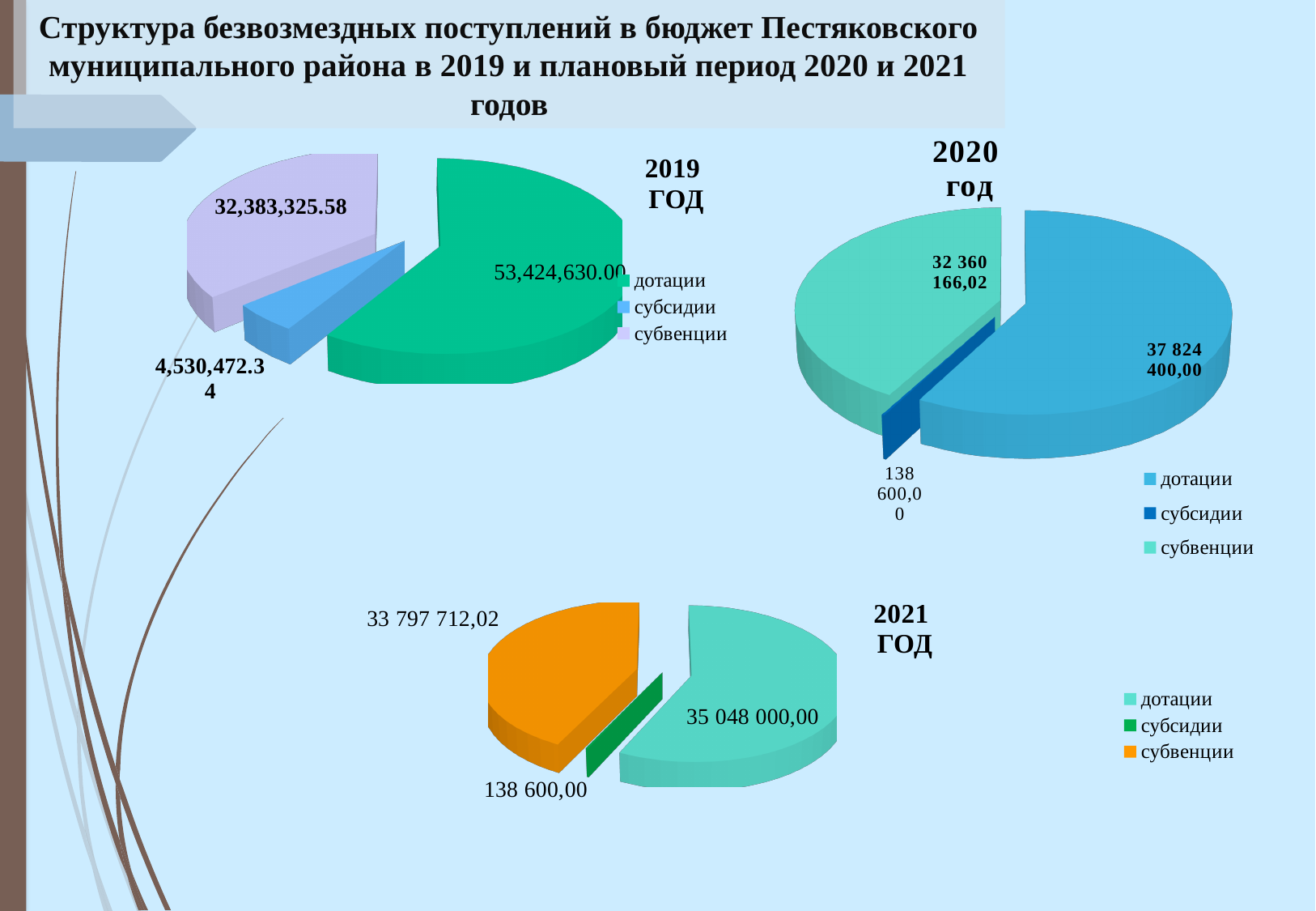
In the 2019 год pie chart, which category has the smallest slice? субсидии What kind of chart is used for the 2020 год data? pie chart In the 2019 год pie chart, what is the value for дотации? 53,424,630.00 In the 2021 год pie chart, what is the value for субсидии? 138 600,00 In the 2020 год pie chart, which category has the largest slice? дотации In the 2019 год pie chart, what is the value for субсидии? 4,530,472.34 In the 2021 год pie chart, what is the value for дотации? 35 048 000,00 In the 2020 год pie chart, what is the value for субвенции? 32 360 166,02 How many entries does the legend of the 2021 год chart list? 3 In the 2021 год pie chart, which is larger, дотации or субвенции? дотации In the 2020 год pie chart, what is the difference between дотации and субвенции? 5 464 233,98 How many slices does the 2019 год pie chart have? 3